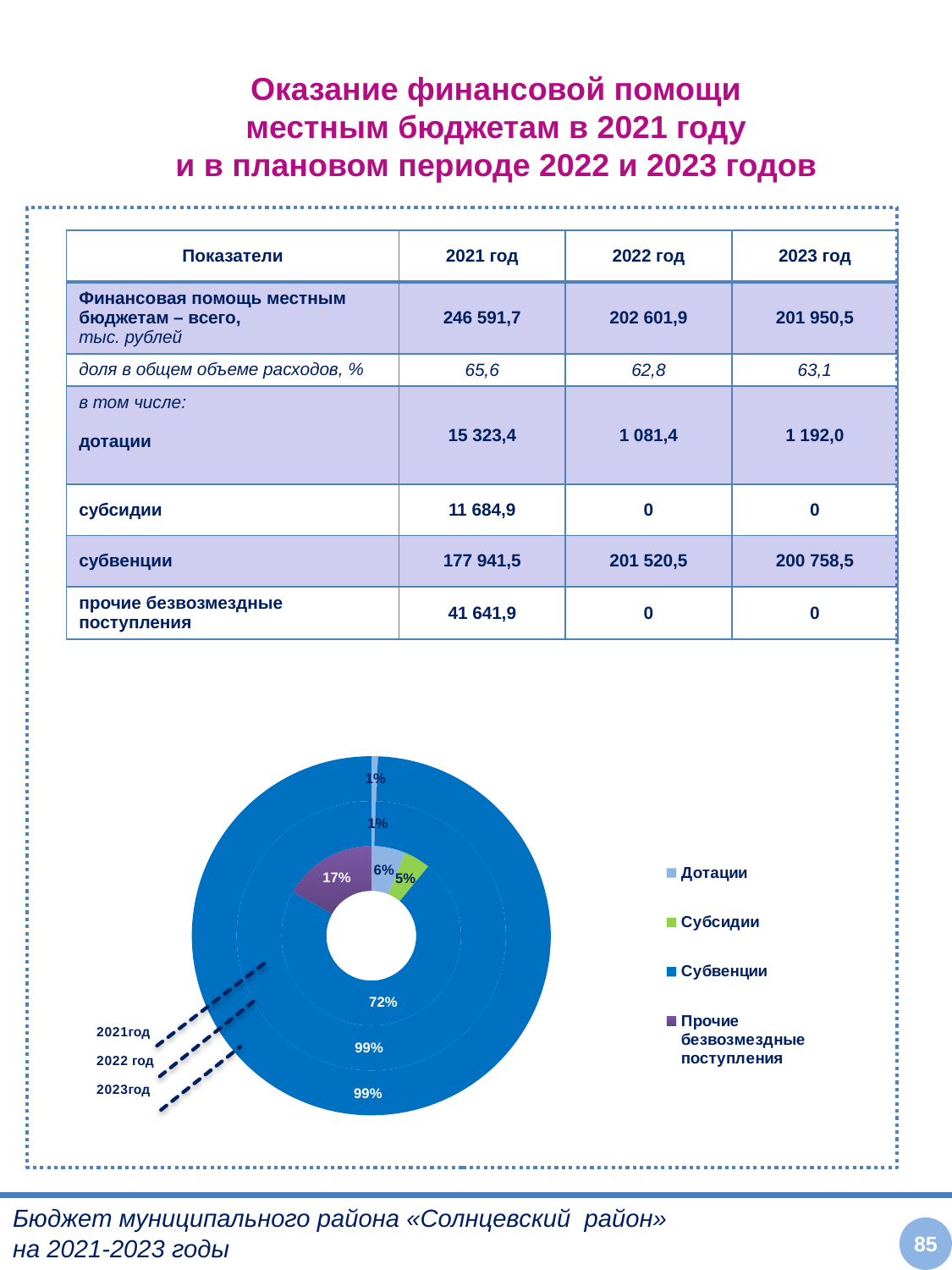
In the chart, what share do Прочие безвозмездные поступления have in the 2021 ring? 17% In the chart, what share do Субвенции have in the 2021 ring? 72% How many rings (years) does the doughnut chart show? 3 In the chart, which category has the largest share in the 2021 ring? Субвенции In the chart, what share do Субвенции have in the 2022 ring? 99% In the chart, which category has the smallest share in the 2021 ring? Субсидии How many series does the chart legend list? 4 What kind of chart is shown on the slide? Doughnut chart In the chart, what is the difference between the shares of Субвенции and Прочие безвозмездные поступления in the 2021 ring? 55%